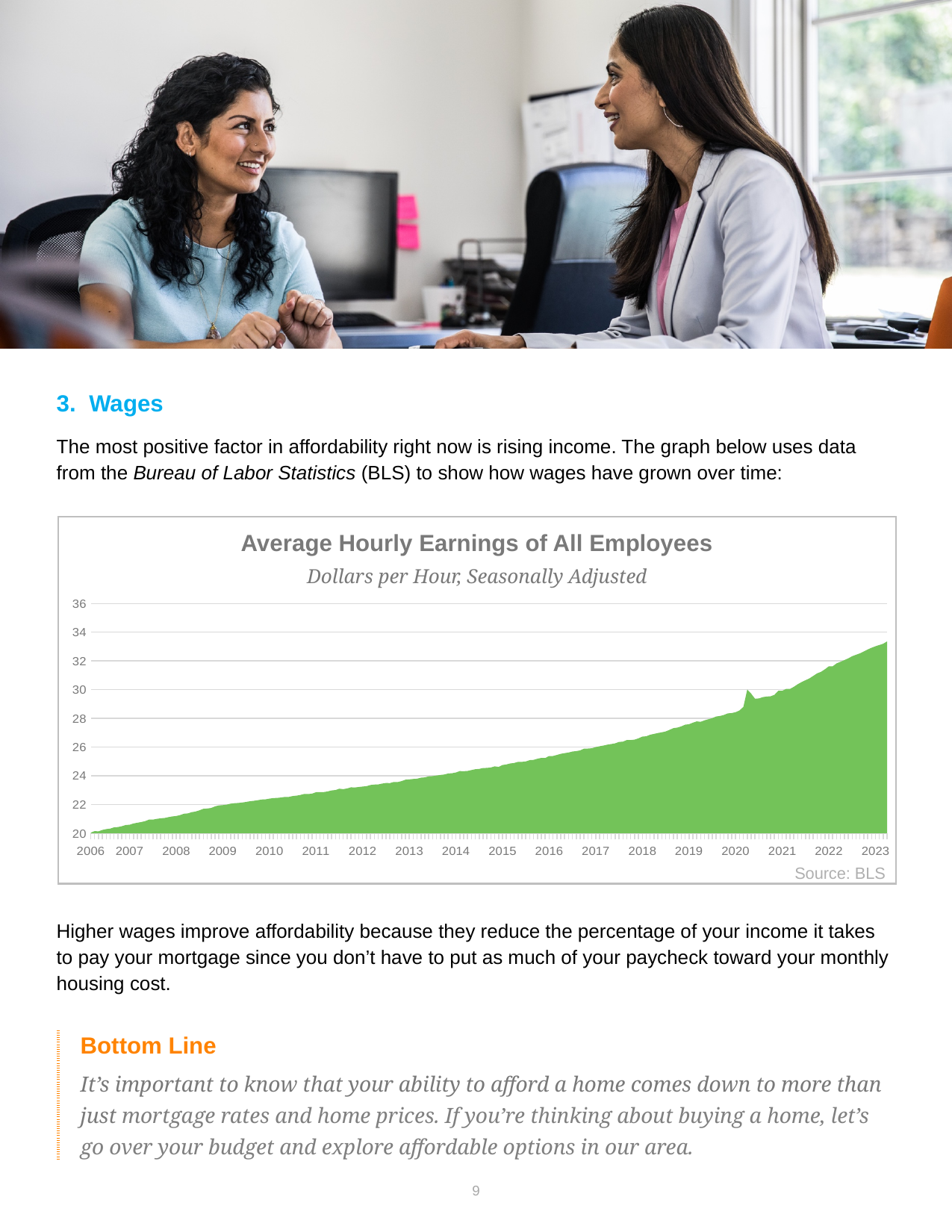
Is the value at the start of 2006 greater or less than 22? less How many years are labeled on the x axis? 18 Which is larger, the value at the start of 2023 or the value at the start of 2012? 2023 Do average hourly earnings rise or fall from 2006 to 2023? Rise In which year labeled on the x axis are average hourly earnings highest? 2023 What is the source cited for the chart's data? BLS What is the title of the chart? Average Hourly Earnings of All Employees Is the value at the start of 2010 greater or less than 24? less Is the value at the start of 2015 greater or less than 24? greater What kind of chart is shown on the slide? Area chart In which year labeled on the x axis are average hourly earnings lowest? 2006